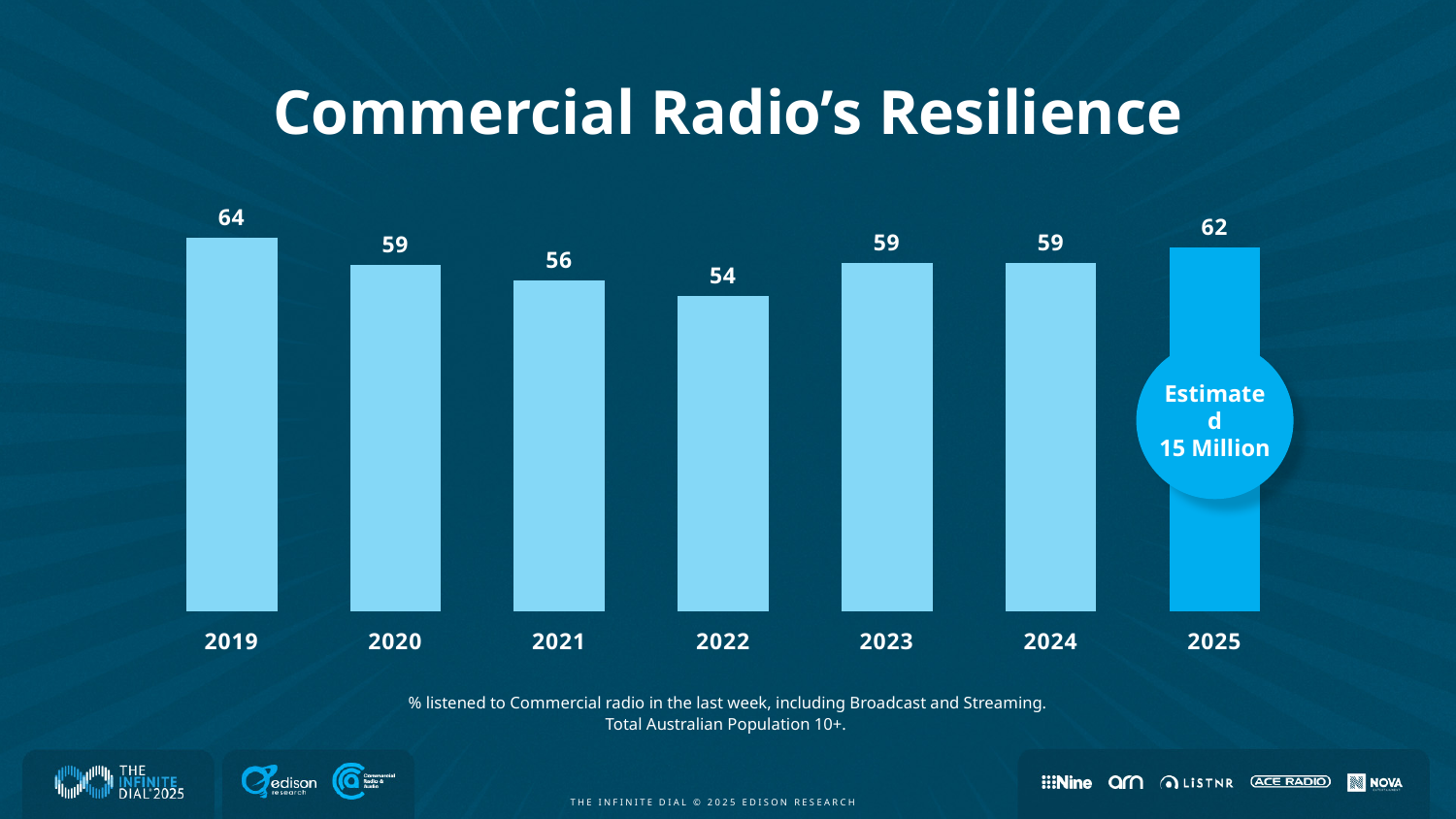
Which year has the highest value? 2019 What kind of chart is shown on the slide? Bar chart What is the value for 2019? 64 What is the value for 2022? 54 What is the difference between the values for 2019 and 2022? 10 Which is larger, the value for 2021 or the value for 2023? 2023 Do the values rise or fall from 2019 to 2022? Fall What is the difference between the values for 2025 and 2024? 3 How many years are shown on the chart? 7 What is the title of the chart? Commercial Radio's Resilience Which year has the lowest value? 2022 What is the value for 2025? 62